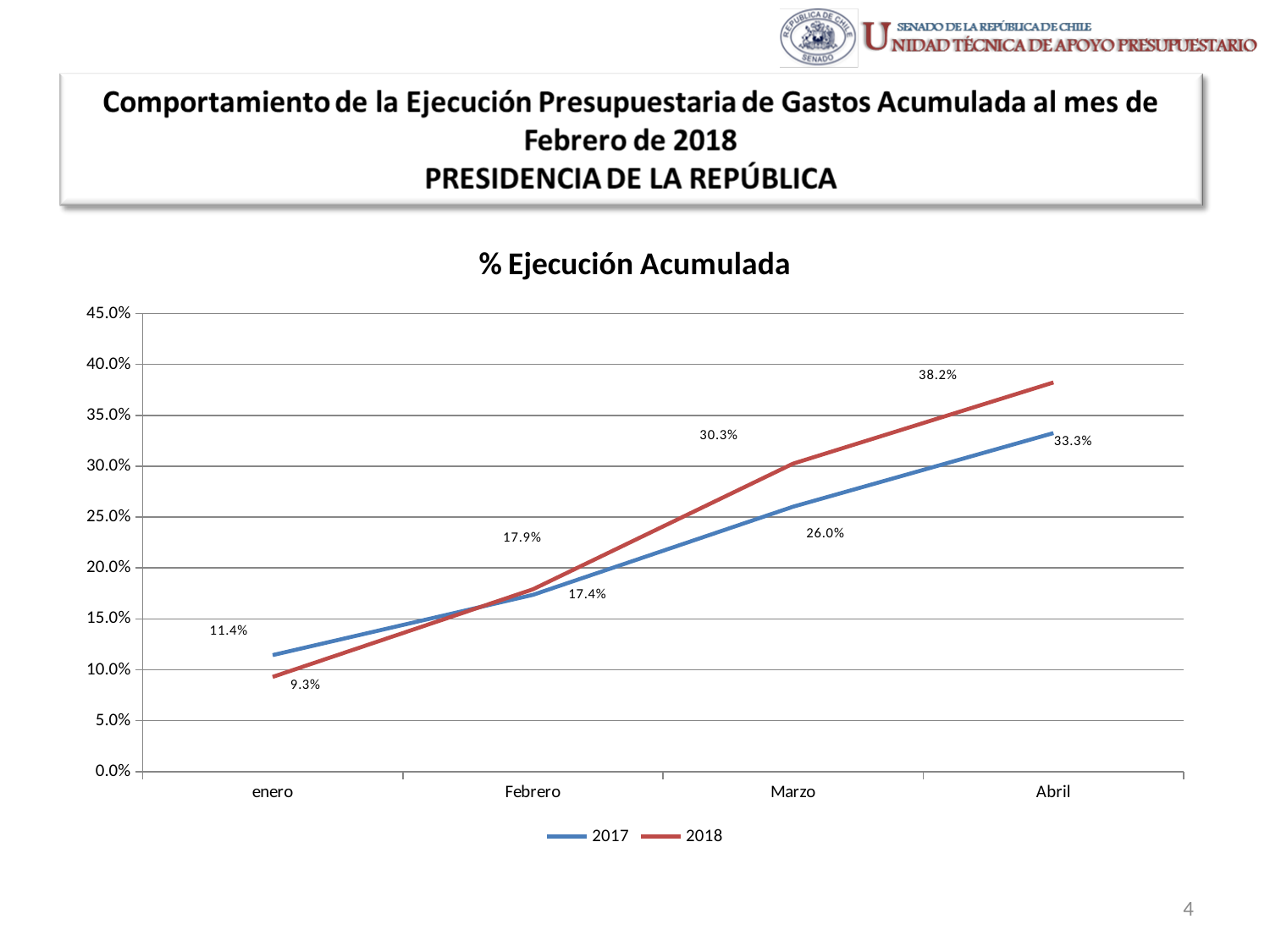
Which series has the larger value in Marzo, 2017 or 2018? 2018 What type of chart is shown on the slide? line chart In which month is the 2018 series lowest? enero What is the difference between the 2018 and 2017 values in Abril? 4.9% What is the value for 2018 in Abril? 38.2% How many months are shown on the x axis? 4 What is the value for 2018 in Marzo? 30.3% What is the value for 2017 in enero? 11.4% In which month is the 2017 series highest? Abril How many series does the legend list? 2 What is the value for 2017 in Febrero? 17.4% Do the values for 2018 rise or fall from enero to Abril? rise